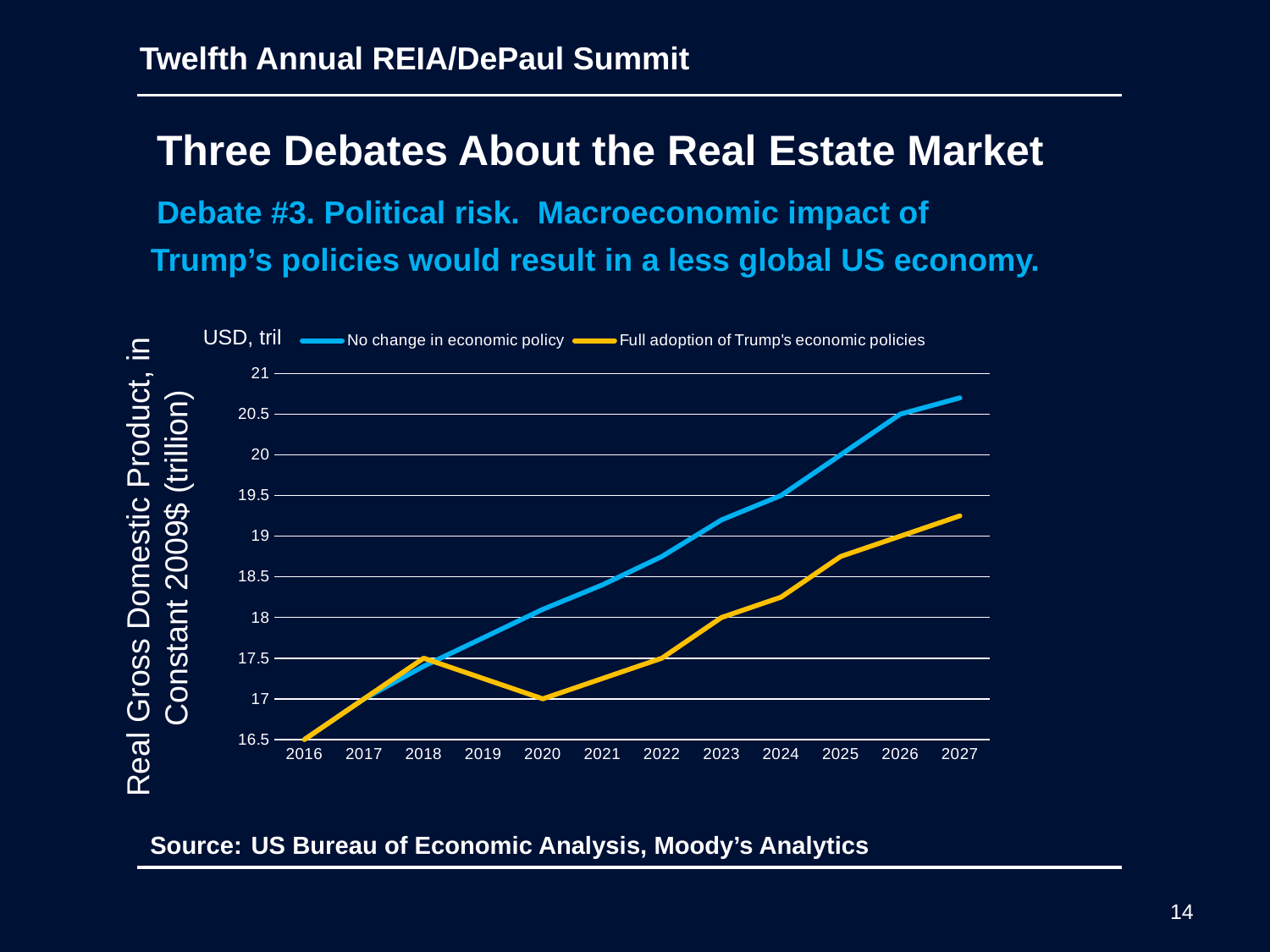
In which year is the 'Full adoption of Trump's economic policies' line at its lowest? 2016 How many years are shown along the x axis of the chart? 12 Is the 2022 value for 'Full adoption of Trump's economic policies' greater or less than 18? less What unit label is shown at the top left of the chart's y axis? USD, tril How many series does the chart's legend list? 2 Is the 2027 value for 'Full adoption of Trump's economic policies' greater or less than 19.5? less What kind of chart is shown on the slide? line chart In 2025, which series has the higher value: 'No change in economic policy' or 'Full adoption of Trump's economic policies'? No change in economic policy What colour is the line for 'Full adoption of Trump's economic policies'? yellow Is the 2027 value for 'No change in economic policy' greater or less than 20.5? greater Does the 'No change in economic policy' line rise or fall from 2016 to 2027? rises